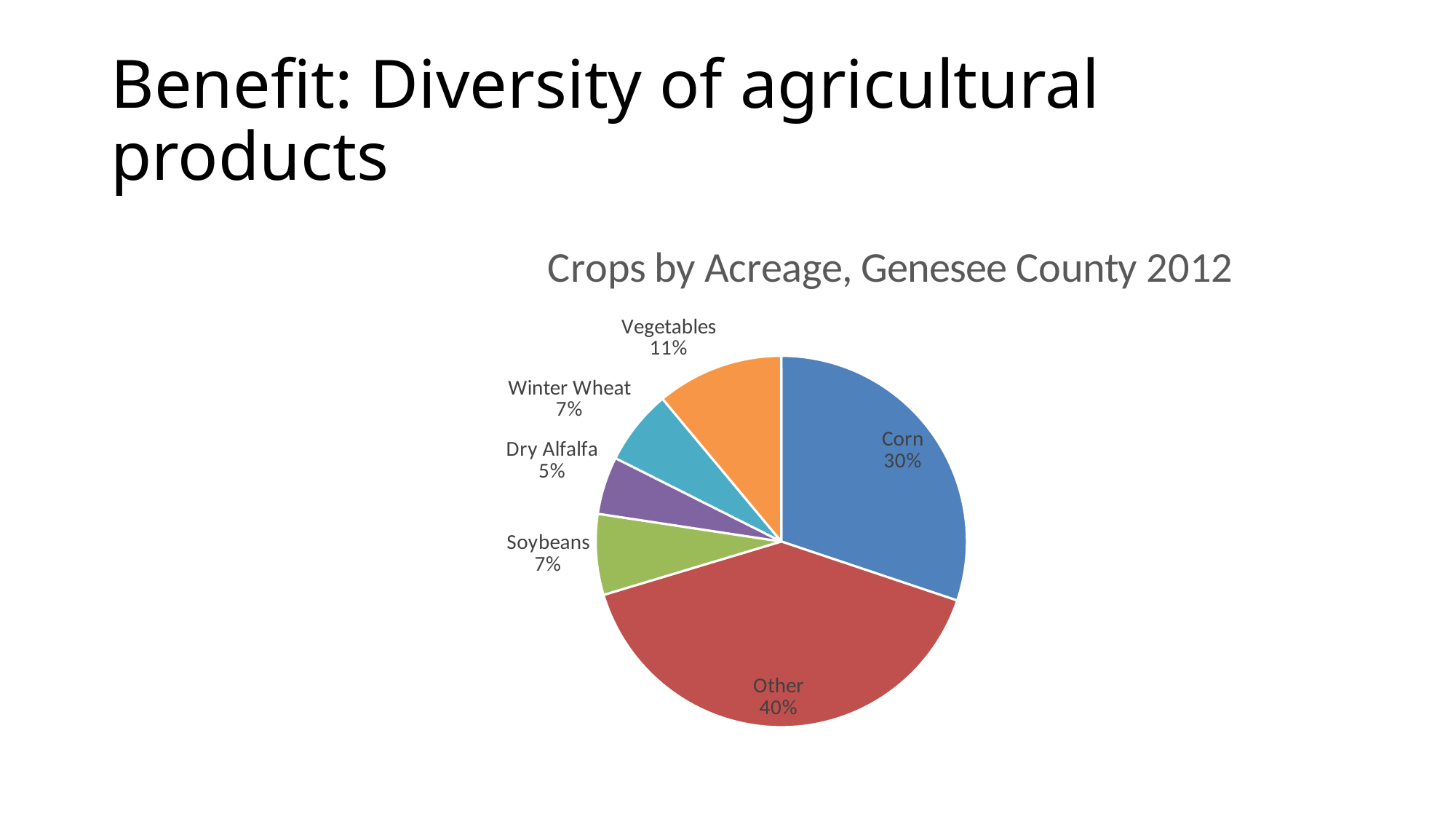
Which category has the largest slice of the pie? Other What kind of chart is shown on the slide? Pie chart What is the title of the chart? Crops by Acreage, Genesee County 2012 What share of the pie does Other represent? 40% Which category has the smallest slice of the pie? Dry Alfalfa What colour is the Corn slice? Blue How many categories are shown in the pie chart? 6 What share of the pie does Corn represent? 30% Which is larger, the share for Vegetables or the share for Winter Wheat? Vegetables What is the value shown for Vegetables? 11% What is the difference between the shares for Other and Corn? 10% What is the value shown for Dry Alfalfa? 5%